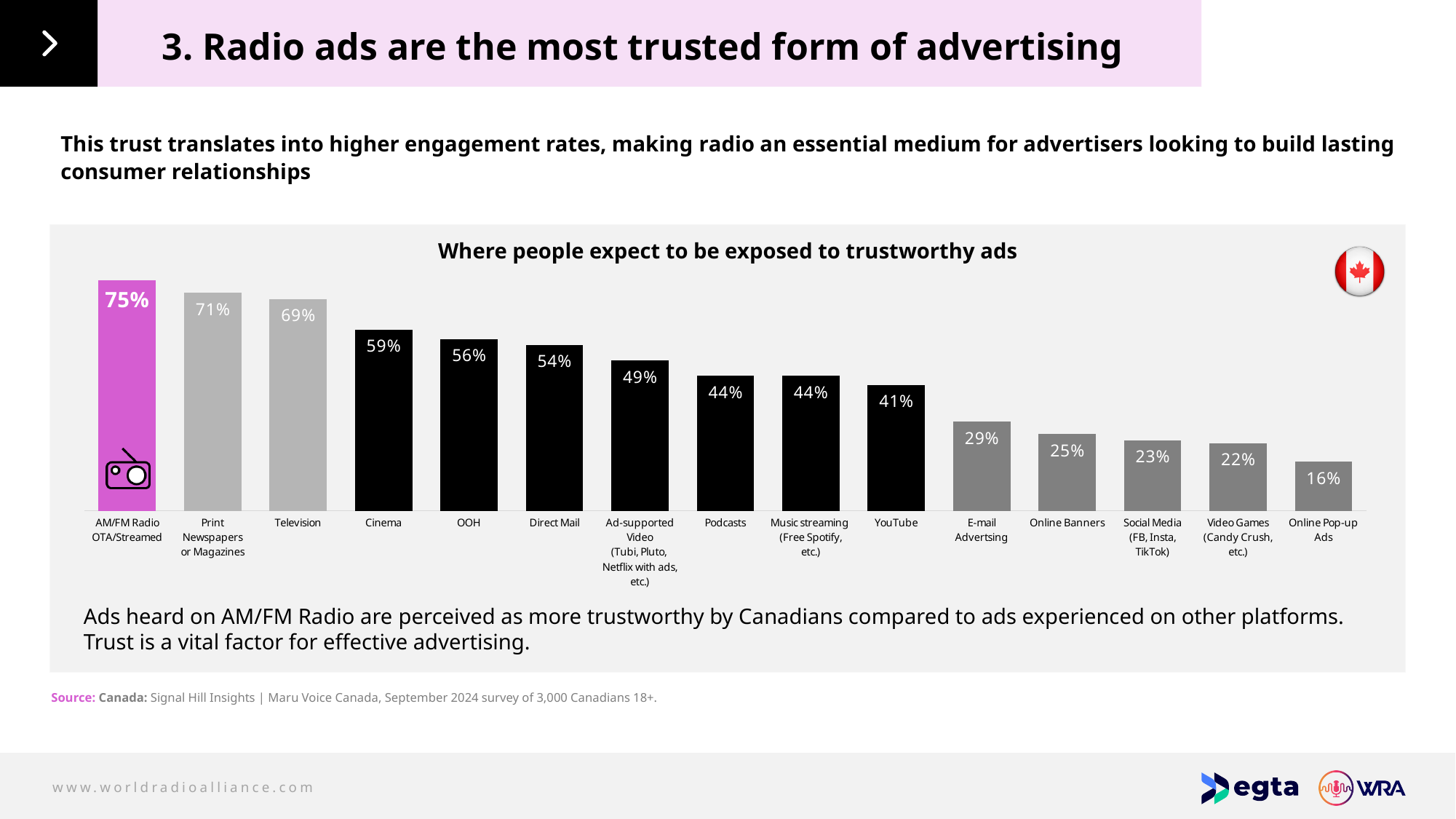
Which category has the lowest value? Online Pop-up Ads What kind of chart is shown on the slide? Bar chart What is the title of the chart? Where people expect to be exposed to trustworthy ads What is the value for Cinema? 59% What is the value for YouTube? 41% What is the value for AM/FM Radio OTA/Streamed? 75% What is the value for Online Pop-up Ads? 16% Which is larger, the value for OOH or the value for Podcasts? OOH Which category has the highest value? AM/FM Radio OTA/Streamed What is the difference between the values for Television and Direct Mail? 15% How many categories are shown in the chart? 15 Do the values rise or fall from left to right along the x axis? Fall